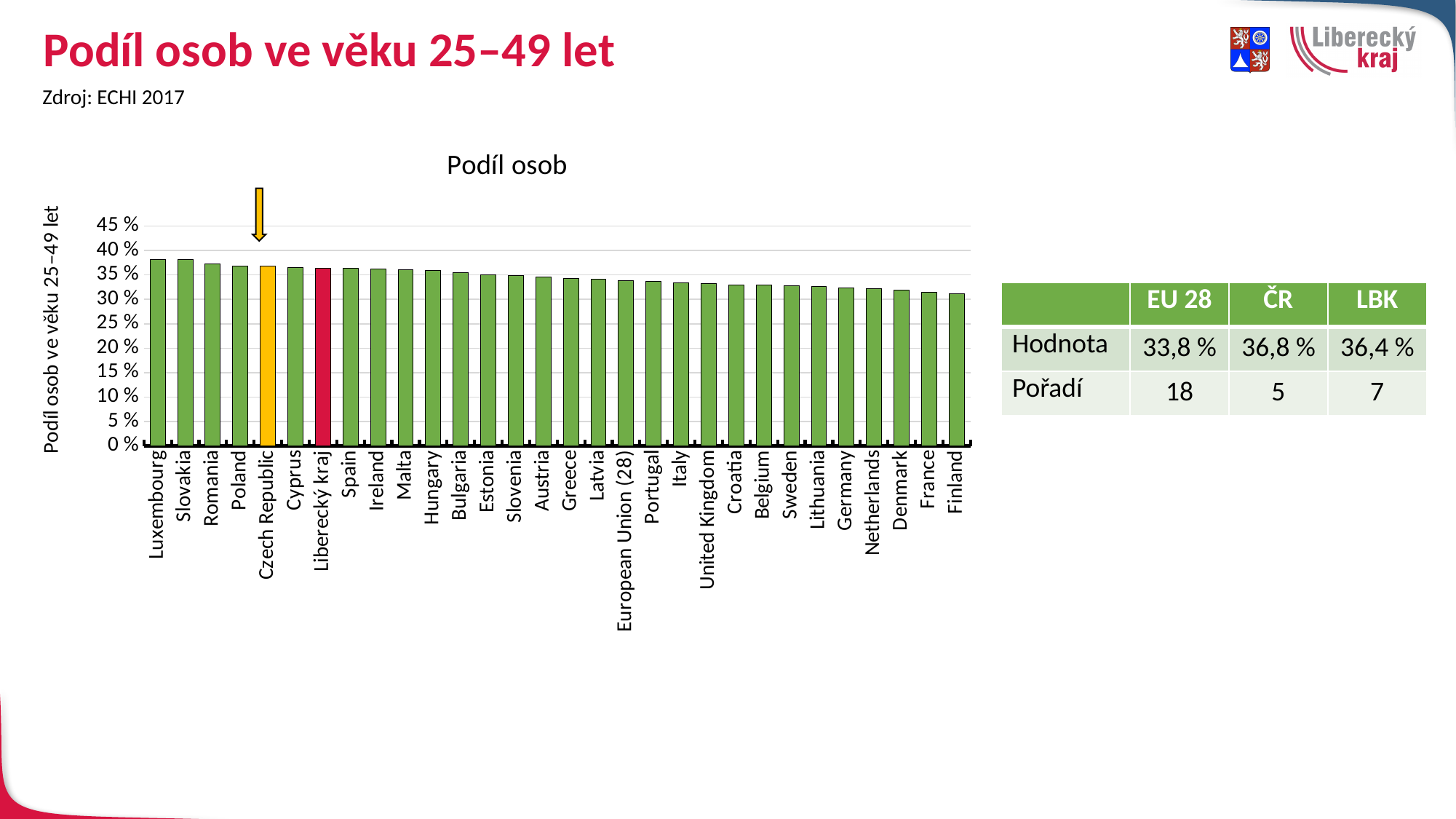
What is the value for Liberecký kraj? 36,4 % Do the values rise or fall from left to right along the x axis? fall What is the value for Czech Republic? 36,8 % Which is larger, the value for Luxembourg or the value for Finland? Luxembourg What is the title of the chart? Podíl osob What is the value for European Union (28)? 33,8 % Is the value for Luxembourg greater or less than 35 %? greater What colour is the bar for Liberecký kraj? red Is the value for Finland greater or less than 35 %? less How many categories (bars) are plotted in the chart? 30 What type of chart is shown on the slide? bar chart What is the difference between the values for Czech Republic and Liberecký kraj? 0,4 %